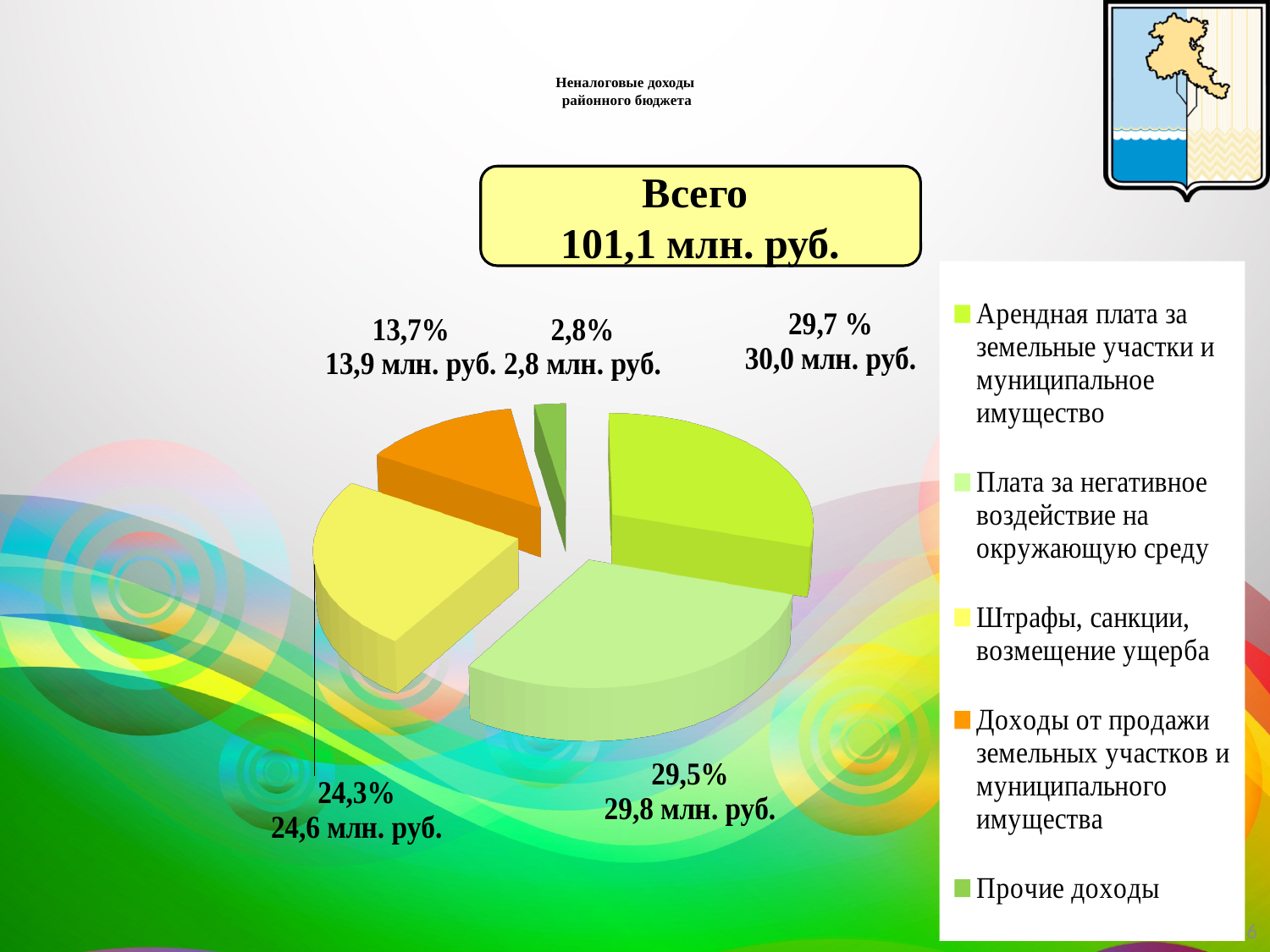
What is the difference in млн. руб. between "Арендная плата за земельные участки и муниципальное имущество" and "Доходы от продажи земельных участков и муниципального имущества"? 16,1 млн. руб. Which category has the smallest share of the pie? Прочие доходы What is the total shown above the pie chart? 101,1 млн. руб. What is the value in млн. руб. for "Плата за негативное воздействие на окружающую среду"? 29,8 млн. руб. Which category has the largest share of the pie? Арендная плата за земельные участки и муниципальное имущество What share of the pie does "Арендная плата за земельные участки и муниципальное имущество" have? 29,7 % What percentage share does "Доходы от продажи земельных участков и муниципального имущества" have? 13,7% What is the value for "Прочие доходы"? 2,8 млн. руб. What is the value in млн. руб. for "Штрафы, санкции, возмещение ущерба"? 24,6 млн. руб. What type of chart is shown on the slide? Pie chart What colour is the slice for "Доходы от продажи земельных участков и муниципального имущества"? Orange How many categories does the legend list? 5